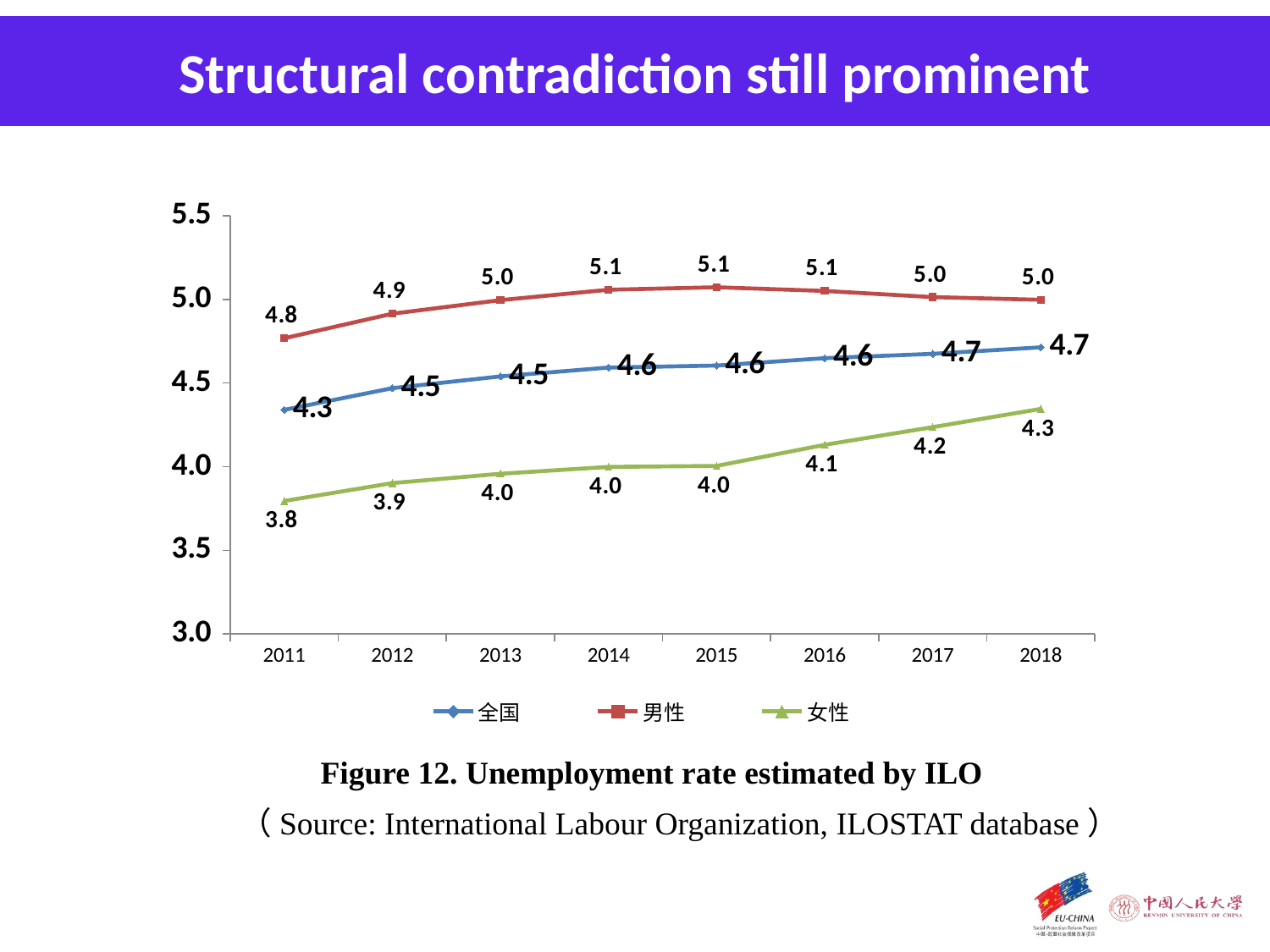
What type of chart is shown on the slide? line chart Which series has the highest value in 2015? 男性 In which year is the value for 女性 lowest? 2011 Does the 女性 series rise or fall from 2011 to 2018? rise Which is larger, the 全国 value in 2018 or the 女性 value in 2018? 全国 What is the value for 男性 in 2011? 4.8 What is the value for 全国 in 2014? 4.6 How many series does the legend list? 3 What is the value for 女性 in 2018? 4.3 What is the difference between the 男性 and 女性 values in 2013? 1.0 How many years are plotted along the x axis? 8 What is the figure caption below the chart? Figure 12. Unemployment rate estimated by ILO